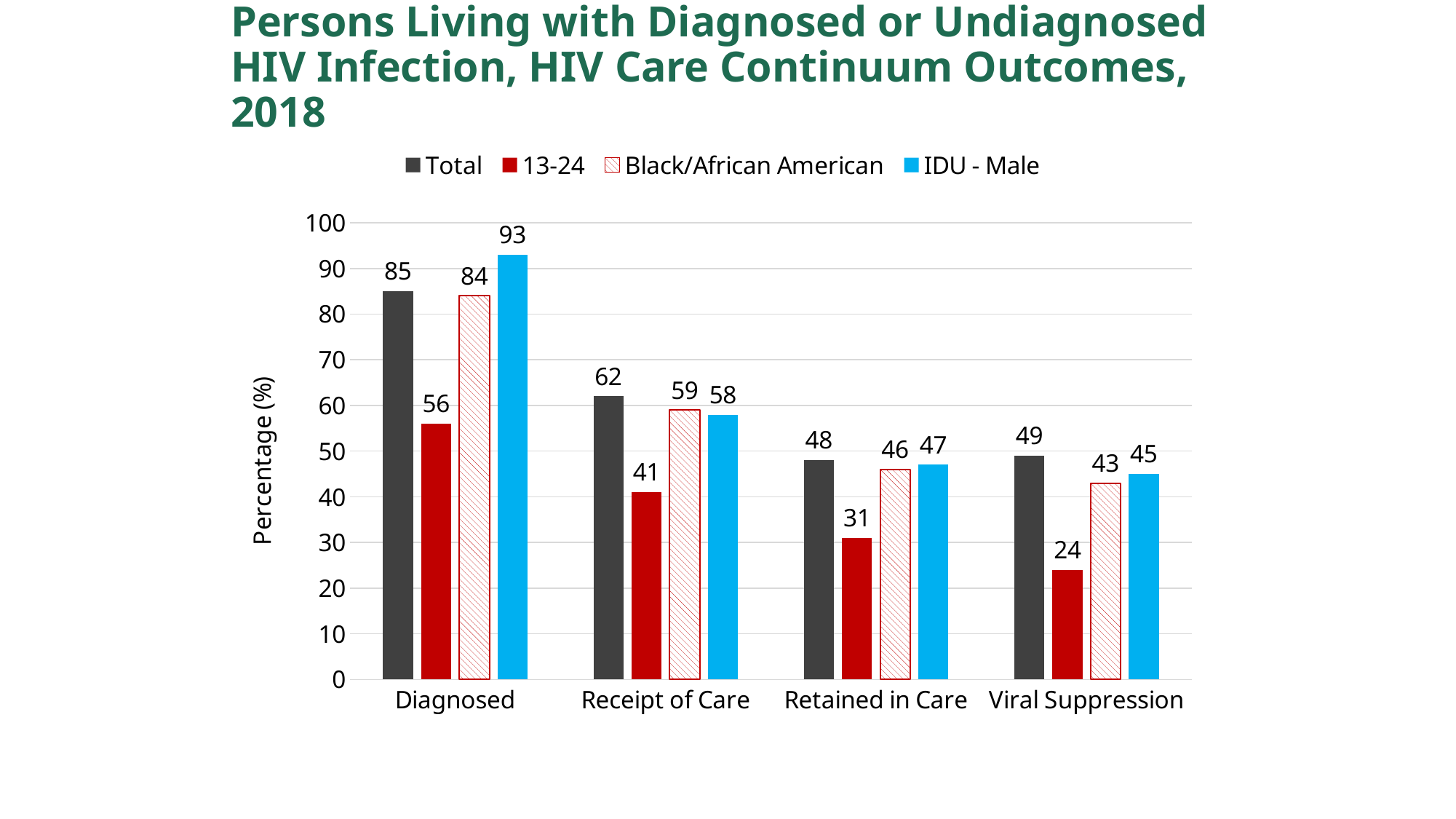
What is the label of the y axis? Percentage (%) What is the value for the 13-24 series for Viral Suppression? 24 What is the Black/African American value for Retained in Care? 46 What is the IDU - Male value for Receipt of Care? 58 How many categories are shown on the x axis? 4 What is the Total value for Diagnosed? 85 What is the difference between the Total and 13-24 values for Receipt of Care? 21 What kind of chart is shown on the slide? Bar chart Which series has the highest value for Diagnosed? IDU - Male Which is larger for Viral Suppression: the Total value or the IDU - Male value? Total Which series has the lowest value for Retained in Care? 13-24 How many series does the legend list? 4